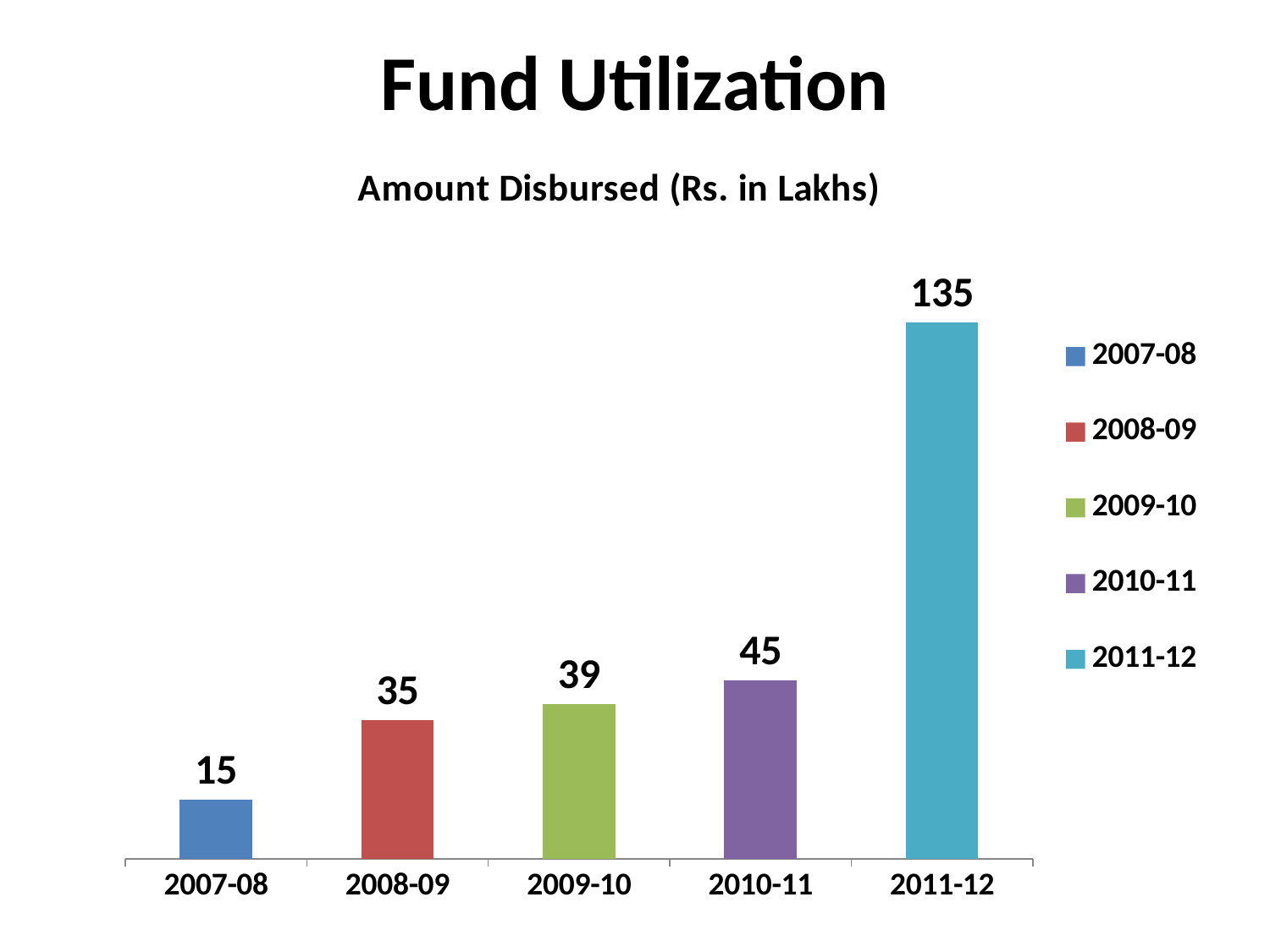
What is the amount disbursed for 2011-12? 135 Which year has the lowest amount disbursed? 2007-08 What is the difference between the amounts disbursed in 2011-12 and 2010-11? 90 What is the amount disbursed for 2009-10? 39 How many entries does the legend list? 5 Do the amounts disbursed rise or fall from 2007-08 to 2011-12? Rise Which year has a larger amount disbursed, 2009-10 or 2010-11? 2010-11 What is the difference between the amounts disbursed in 2008-09 and 2007-08? 20 How many years are shown on the chart? 5 Which year has the highest amount disbursed? 2011-12 What kind of chart is shown on the slide? Bar chart What is the amount disbursed for 2007-08? 15